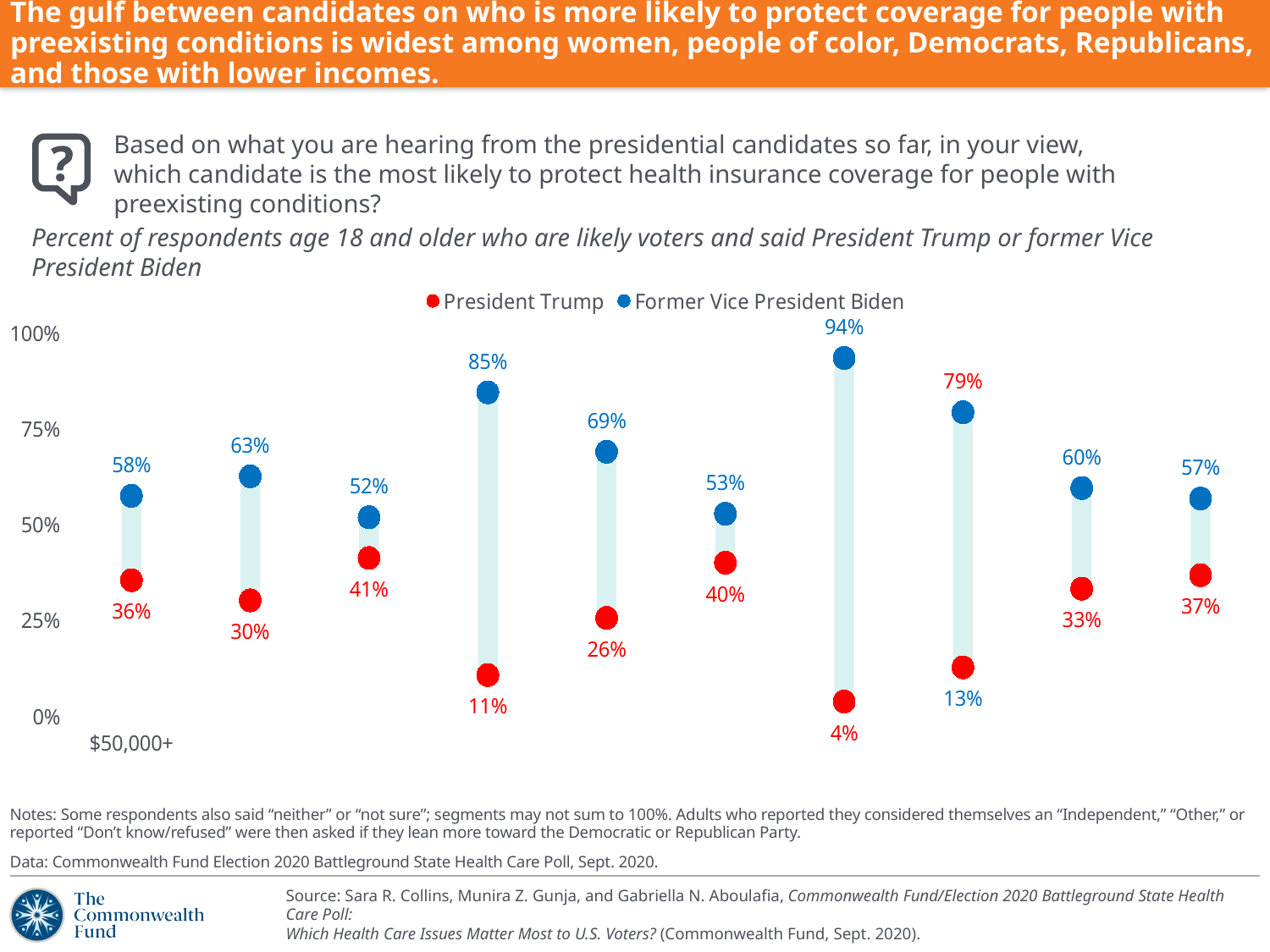
What is the difference between Biden's 94% and Trump's 4% in the same group? 90 percentage points In the last (rightmost) group, what is the value for Former Vice President Biden? 57% In the first (leftmost) group, which candidate has the larger value? Former Vice President Biden How many series does the legend list? 2 What is the lowest value shown for President Trump? 4% In the first (leftmost) group, what is the value for Former Vice President Biden? 58% What are the two series named in the legend? President Trump and Former Vice President Biden What is the highest value shown for Former Vice President Biden? 94% In the group where Biden is at 94%, what is the value for President Trump? 4% In the group where Biden is at 85%, what is the difference between the Biden and Trump values? 74 percentage points How many groups of paired points are plotted on the chart? 10 In the first (leftmost) group, what is the value for President Trump? 36%